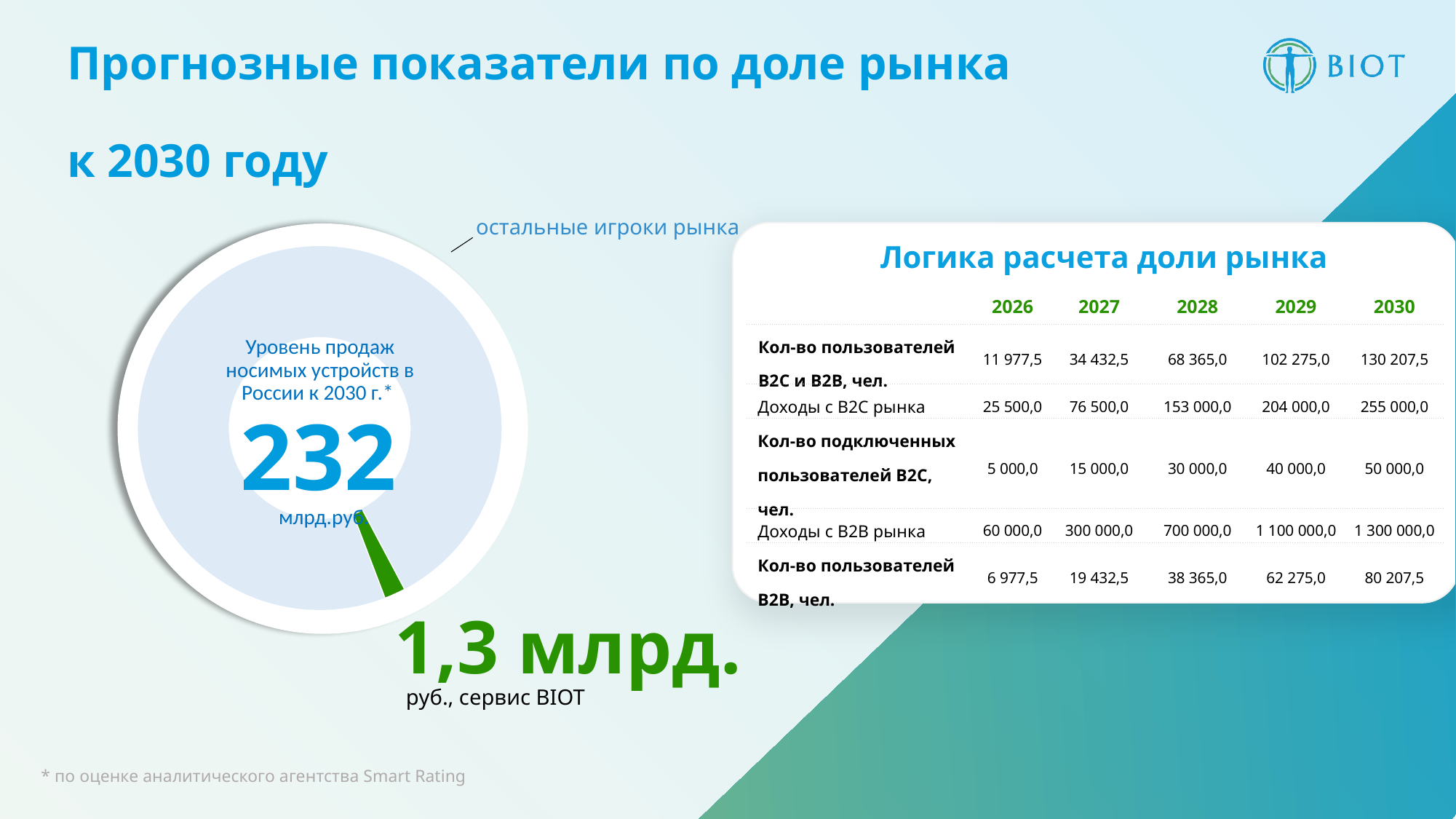
In the donut chart, which is larger: the 'сервис BIOT' segment or the 'остальные игроки рынка' segment? остальные игроки рынка What value is shown for the 'сервис BIOT' segment of the donut chart? 1,3 млрд. руб. What is the label of the large light-blue segment of the donut chart? остальные игроки рынка Which segment of the donut chart is the largest? остальные игроки рынка Which segment of the donut chart is the smallest? сервис BIOT What kind of chart is shown on the left of the slide? pie chart (donut) What colour is the 'сервис BIOT' segment in the donut chart? green By how much does the total of 232 млрд. руб. exceed the 1,3 млрд. руб. of сервис BIOT in the donut chart? 230,7 млрд. руб. How many segments does the donut chart on the left have? 2 What total sales level of wearable devices in Russia by 2030 is shown in the centre of the donut chart? 232 млрд.руб.